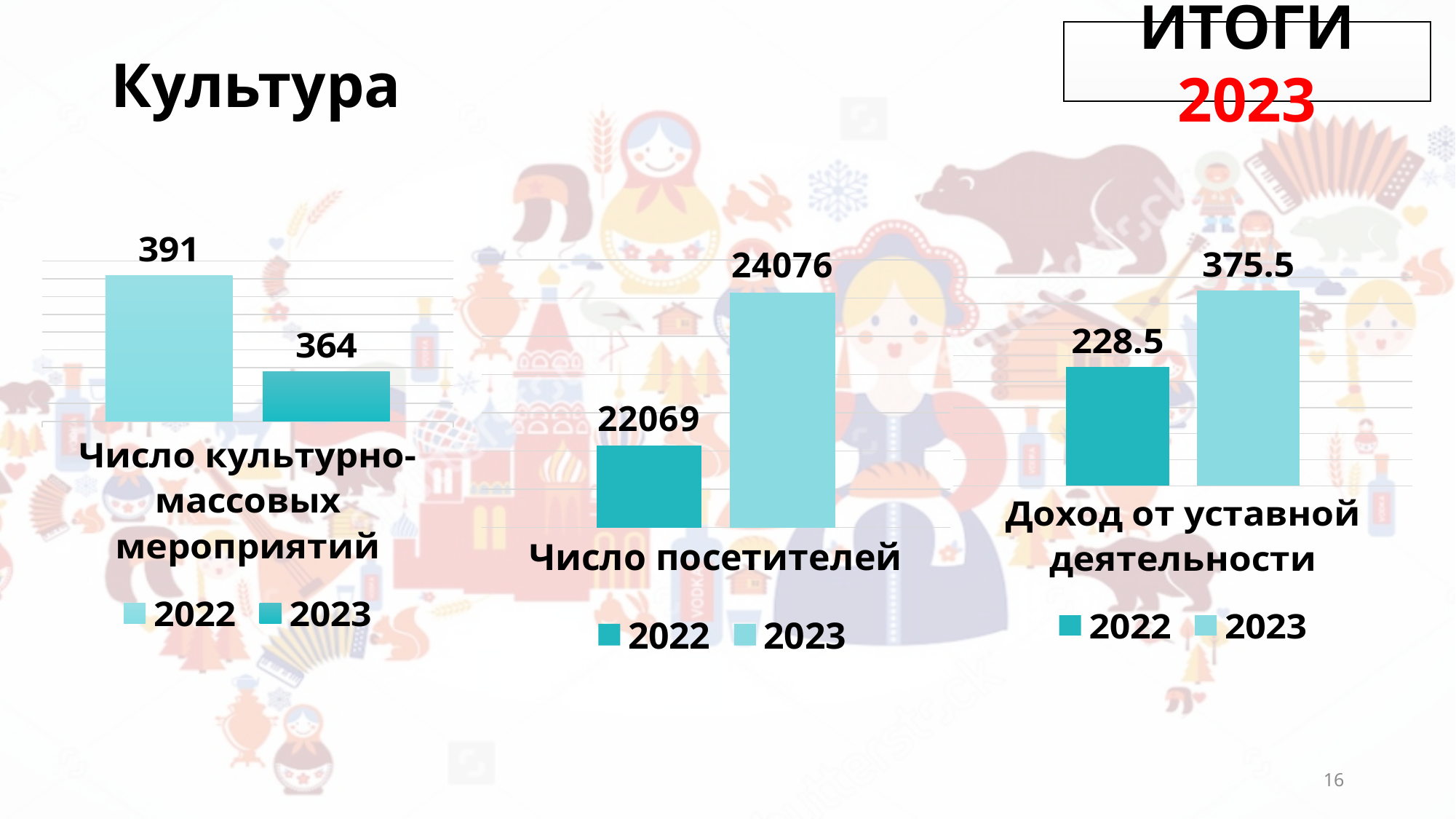
In the chart 'Число культурно-массовых мероприятий', which year has the higher value, 2022 or 2023? 2022 In the chart 'Число посетителей', which year has the lowest value? 2022 In the chart 'Доход от уставной деятельности', what is the difference between the 2023 and 2022 values? 147 How many series does the legend of the chart 'Число посетителей' list? 2 In the chart 'Число культурно-массовых мероприятий', what is the value for 2022? 391 In the chart 'Число культурно-массовых мероприятий', do the values rise or fall from 2022 to 2023? fall In the chart 'Число посетителей', what is the value for 2023? 24076 In the chart 'Число посетителей', what is the difference between the 2023 and 2022 values? 2007 What kind of chart is 'Доход от уставной деятельности'? bar chart In the chart 'Доход от уставной деятельности', what is the value for 2022? 228.5 In the chart 'Число культурно-массовых мероприятий', what is the value for 2023? 364 In the chart 'Доход от уставной деятельности', which year has the highest value? 2023